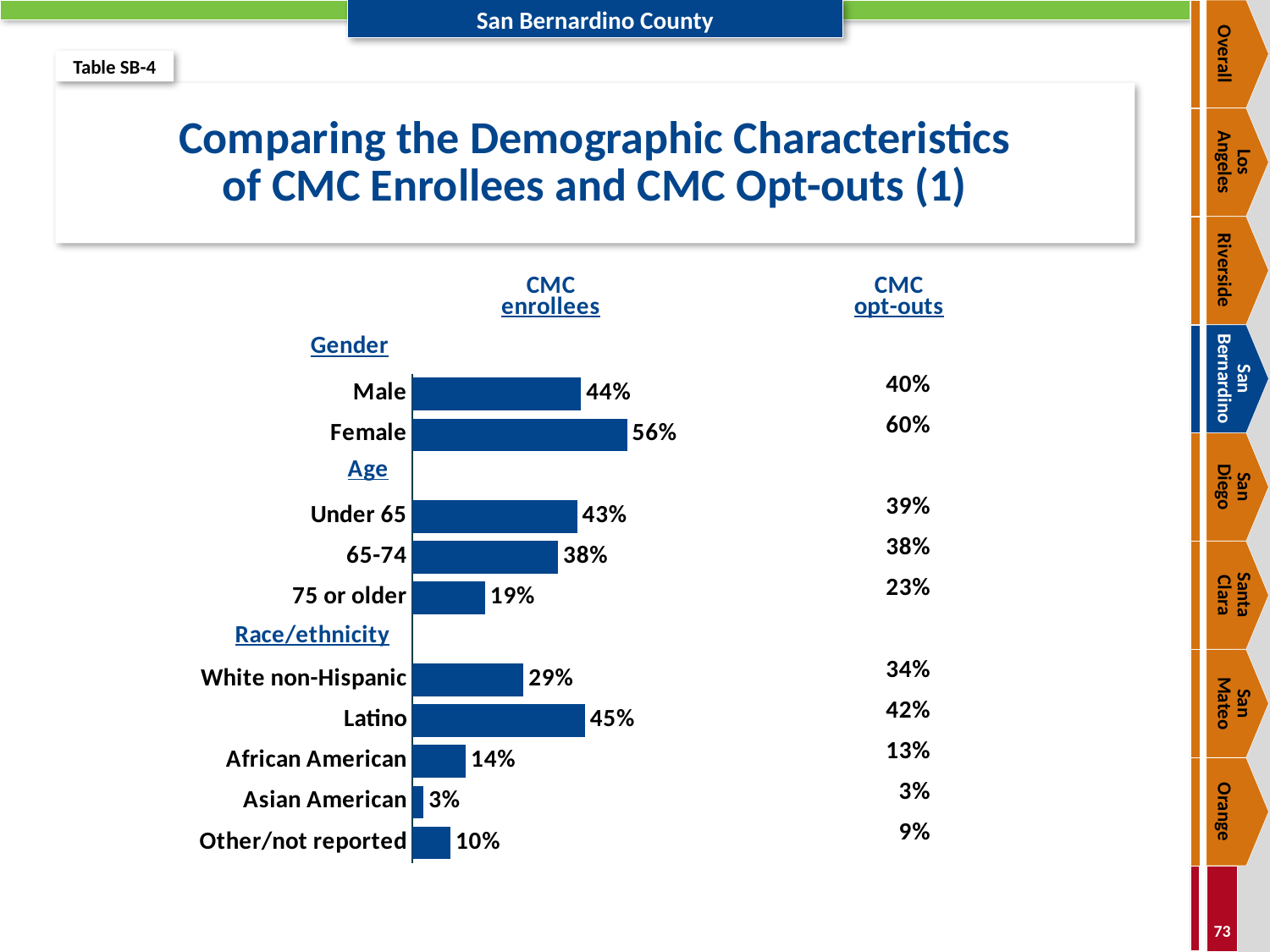
What kind of chart is used to show the CMC enrollees values? bar chart How many bars are plotted in the CMC enrollees chart? 10 Among the race/ethnicity categories, which has the highest percentage of CMC enrollees? Latino What percentage of CMC enrollees are 75 or older? 19% Which is larger for CMC enrollees: the percentage Under 65 or the percentage 65-74? Under 65 What is the title of the slide containing the chart? Comparing the Demographic Characteristics of CMC Enrollees and CMC Opt-outs (1) What percentage of CMC enrollees are Latino? 45% What percentage of CMC enrollees are Female? 56% What is the difference between the Under 65 percentage for CMC enrollees and for CMC opt-outs? 4% Among the race/ethnicity categories, which has the lowest percentage of CMC enrollees? Asian American What is the difference between the Female and Male percentages for CMC enrollees? 12% What percentage of CMC opt-outs are White non-Hispanic? 34%